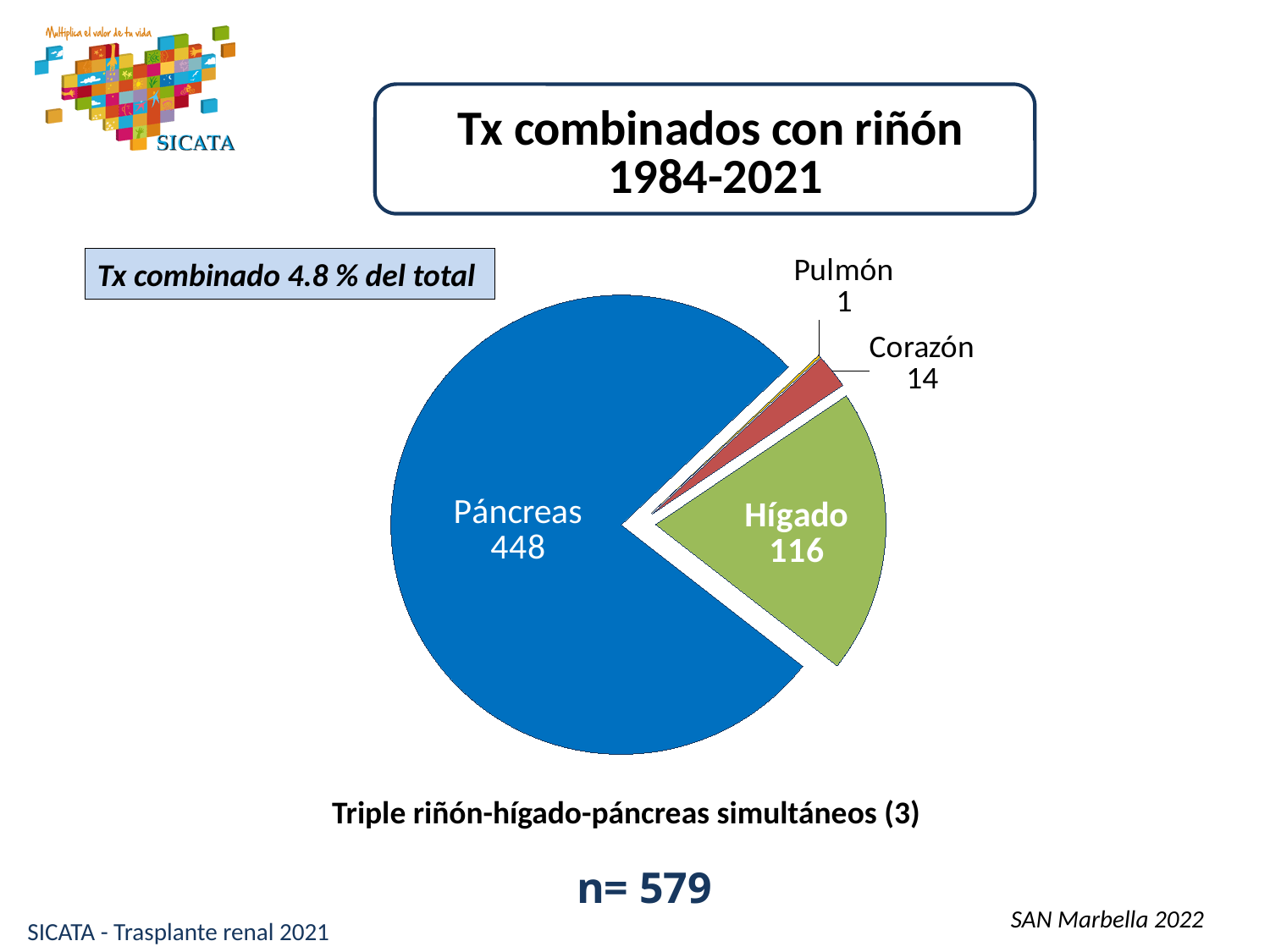
Which category has the smallest slice in the pie chart? Pulmón What is the value for Hígado in the pie chart? 116 What is the total of all slices in the pie chart (n)? 579 How many slices does the pie chart have? 4 What is the value for Páncreas in the pie chart? 448 Which is larger, the value for Corazón or the value for Hígado? Hígado What is the value for Pulmón in the pie chart? 1 What type of chart is shown on the slide? pie chart What is the value for Corazón in the pie chart? 14 Which category has the largest slice in the pie chart? Páncreas What is the difference between the values for Páncreas and Hígado? 332 What is the title of the chart on the slide? Tx combinados con riñón 1984-2021